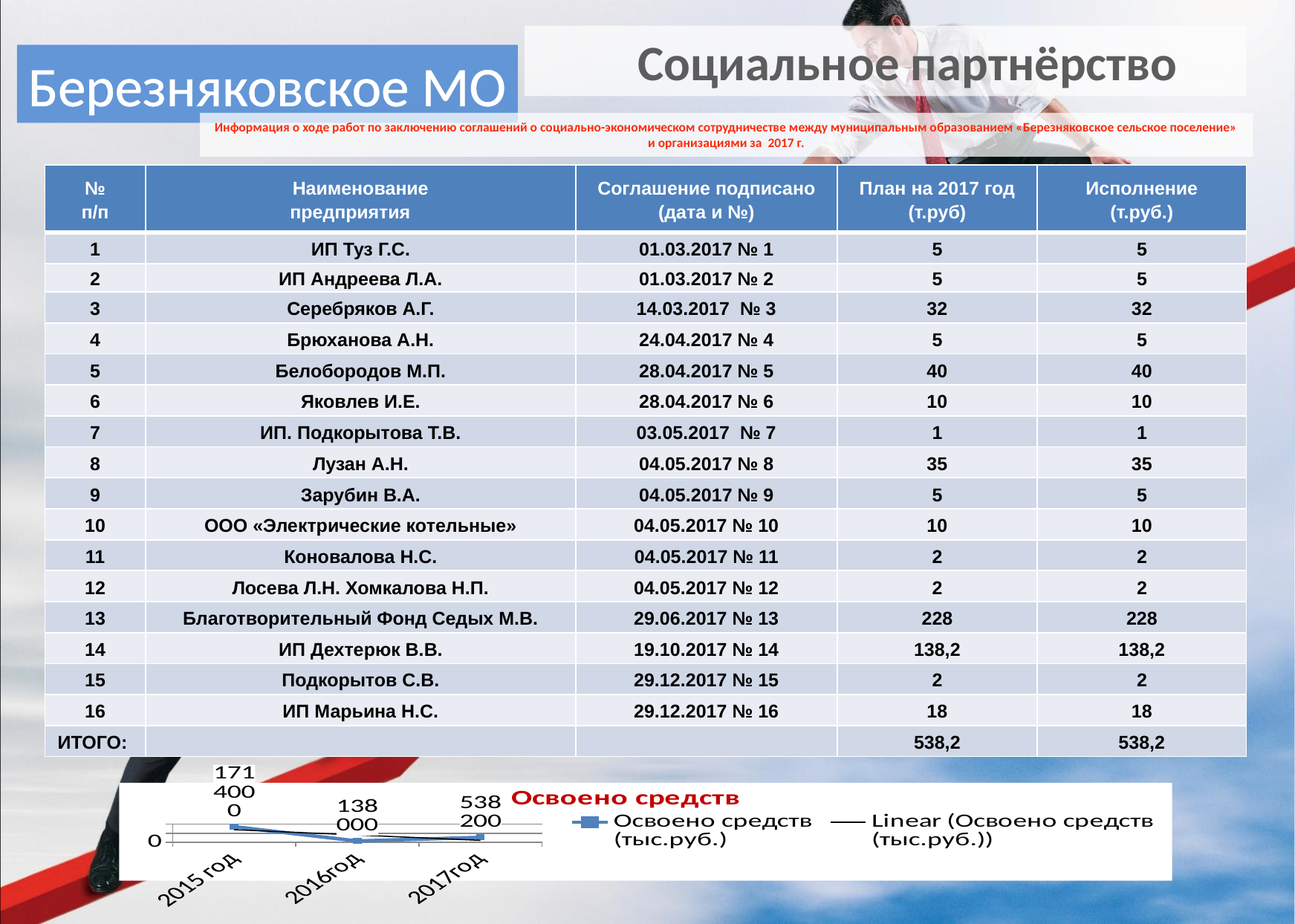
What is the difference between the values for 2017год and 2016год in the chart? 400 200 What kind of chart is shown at the bottom of the slide? line chart What is the value plotted for 2017год in the chart? 538 200 What is the title of the chart at the bottom of the slide? Освоено средств How many entries does the legend of the chart list? 2 What is the value plotted for 2016год in the chart? 138 000 How many categories are plotted along the x axis of the chart? 3 Which year has the highest value in the chart? 2015 год Does the plotted value rise or fall from 2015 год to 2016год? fall Which is larger in the chart, the value for 2016год or the value for 2017год? 2017год Which year has the lowest value in the chart? 2016год What is the name of the first series listed in the chart legend? Освоено средств (тыс.руб.)